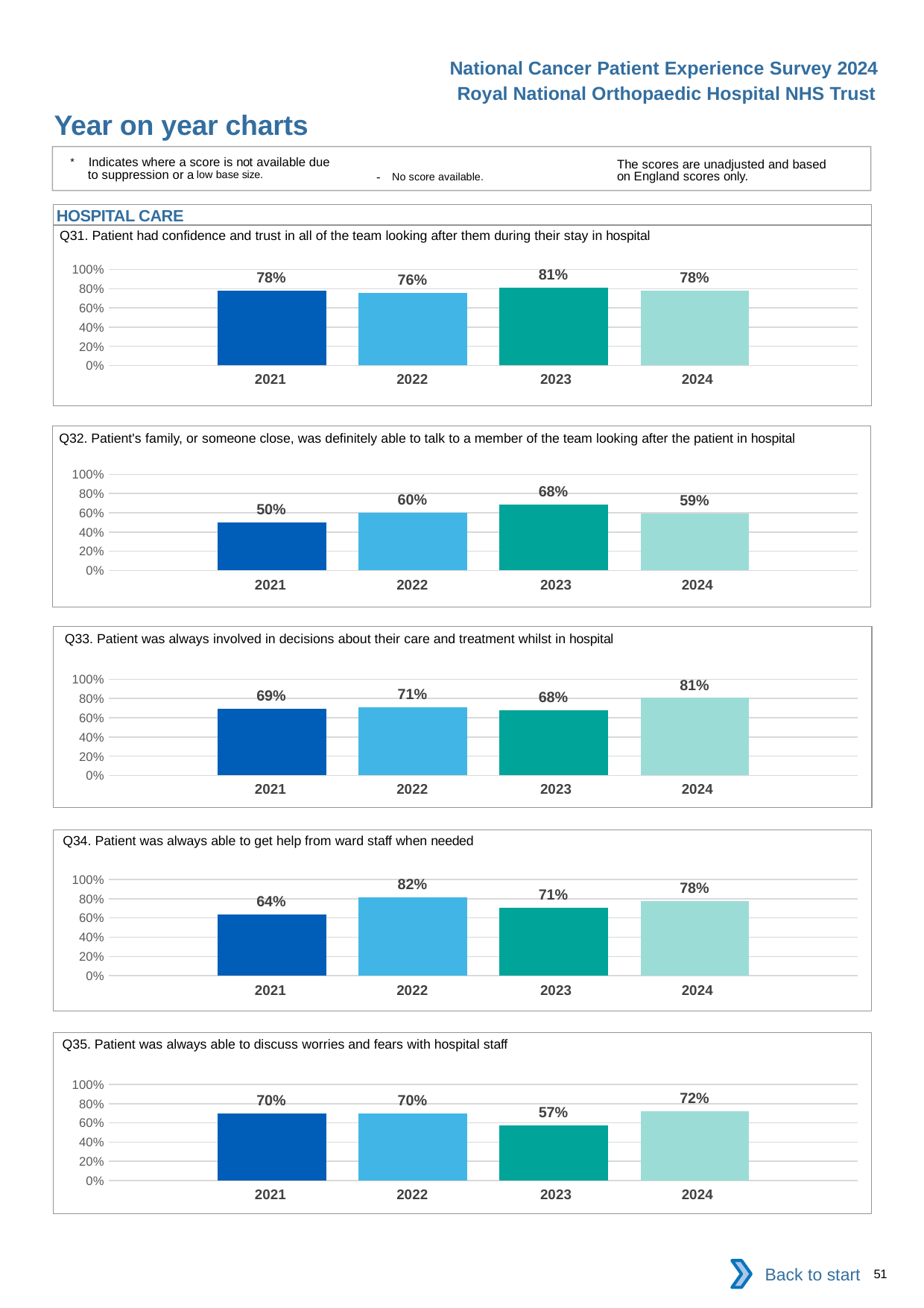
In the Q35 chart, which year has the highest value? 2024 In the Q34 chart, which is larger, the value for 2022 or the value for 2023? 2022 In the Q33 chart, which year has the highest value? 2024 In the Q32 chart, what is the difference between the 2023 and 2024 values? 9 percentage points In the Q35 chart, what is the value for 2023? 57% In the Q31 chart, what is the value for 2023? 81% In the Q34 chart, what is the difference between the 2022 and 2021 values? 18 percentage points In the Q33 chart, what is the value for 2021? 69% In the Q31 chart, is the value for 2022 greater or less than 80%? less How many years are shown on the x axis of the Q31 chart? 4 In the Q32 chart, which year has the lowest value? 2021 What type of chart is the Q32 chart? Bar chart